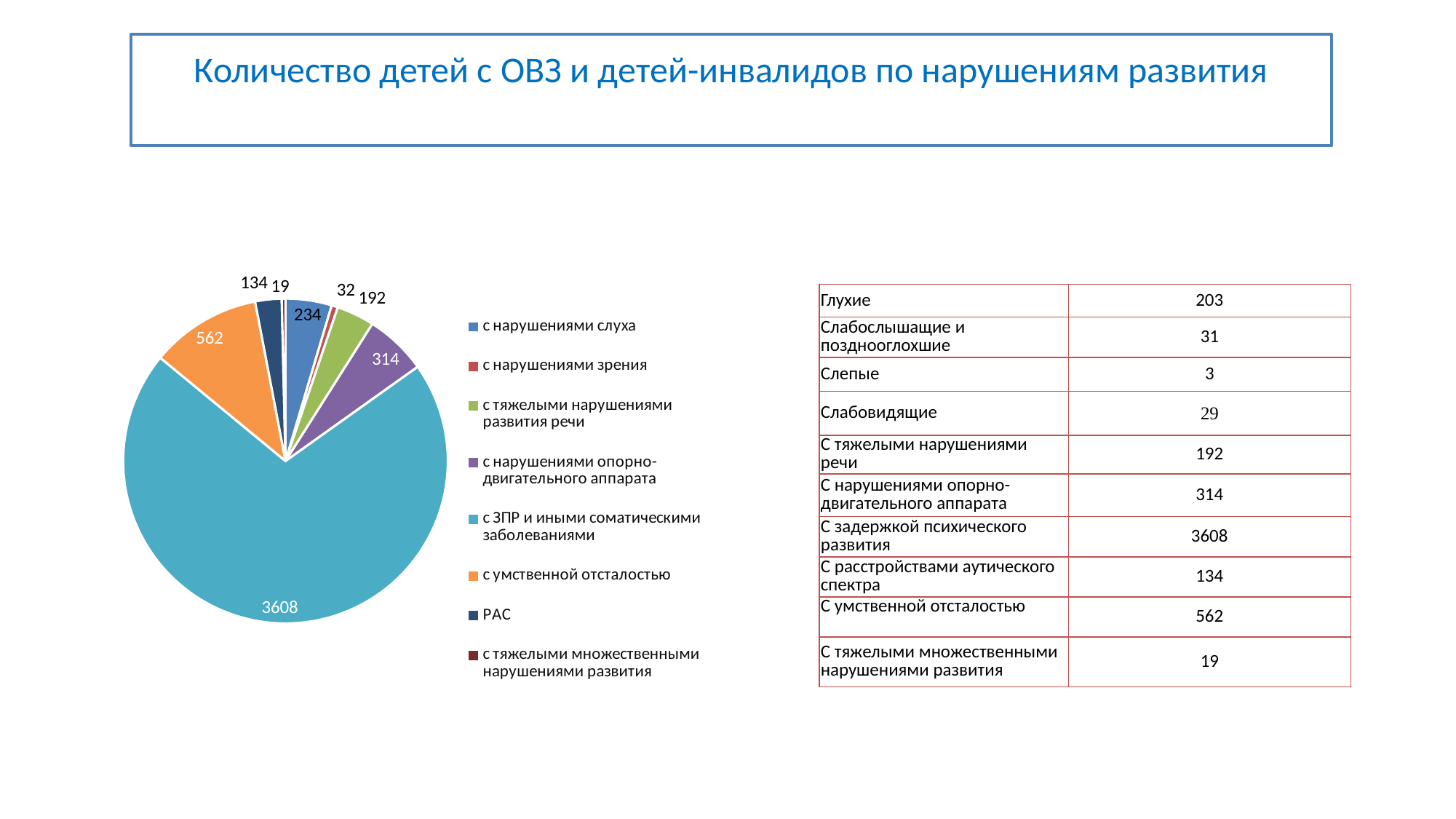
What is the difference between the values for 'с умственной отсталостью' and 'с нарушениями опорно-двигательного аппарата'? 248 What is the title of the slide containing the pie chart? Количество детей с ОВЗ и детей-инвалидов по нарушениям развития What is the value for the slice 'с нарушениями опорно-двигательного аппарата'? 314 What is the value for the slice 'с умственной отсталостью'? 562 Which category has the smallest slice in the pie chart? с тяжелыми множественными нарушениями развития Which is larger: the value for 'с нарушениями слуха' or the value for 'с тяжелыми нарушениями развития речи'? с нарушениями слуха What is the value for the slice 'РАС'? 134 What is the value for the slice 'с нарушениями слуха'? 234 What is the value for the slice 'с ЗПР и иными соматическими заболеваниями'? 3608 What type of chart is shown on the slide? pie chart Which category has the largest slice in the pie chart? с ЗПР и иными соматическими заболеваниями How many slices does the pie chart have? 8